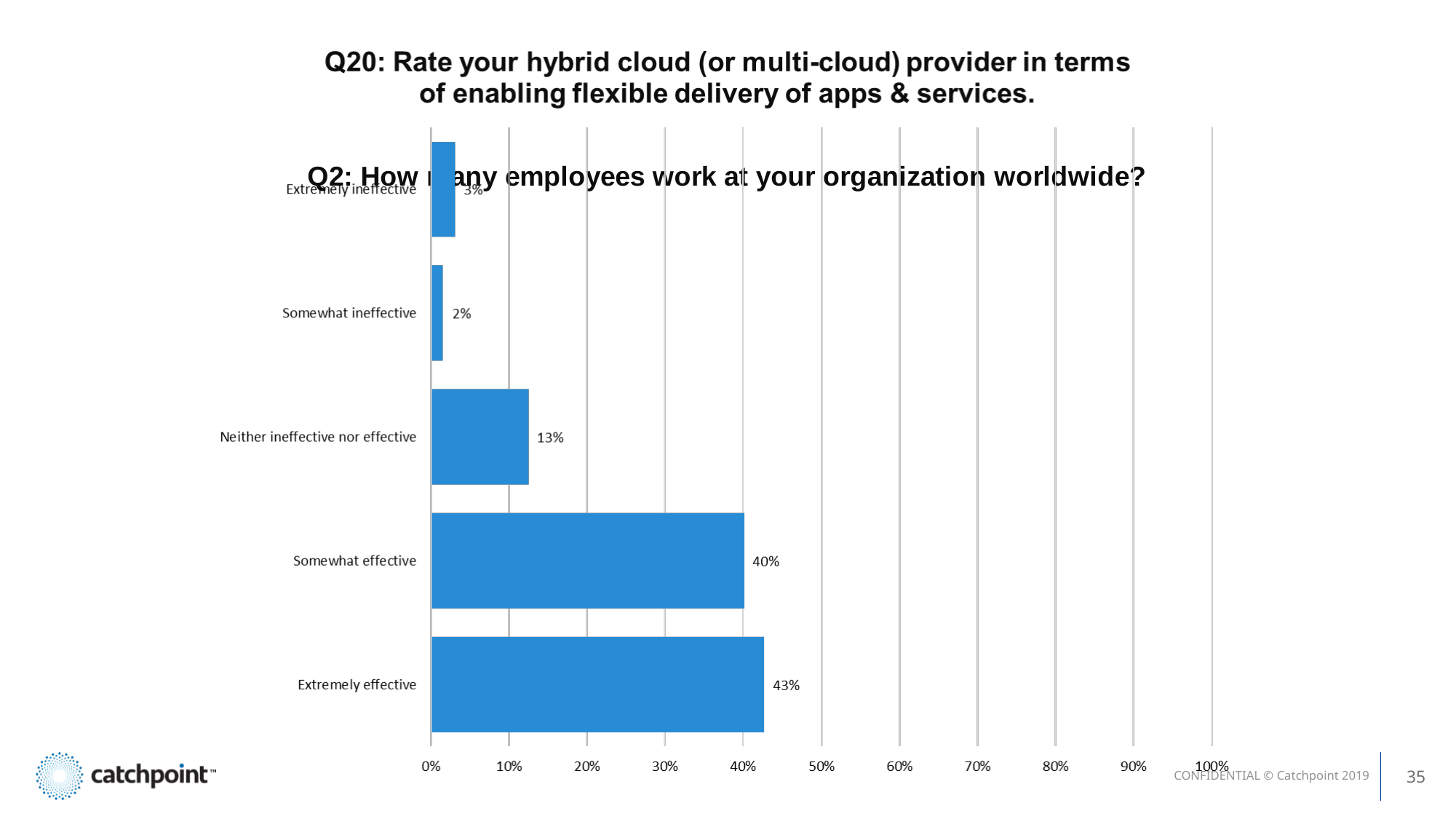
What is the difference between Somewhat effective and Neither ineffective nor effective? 27% Which category has the lowest value? Somewhat ineffective What is the value for Somewhat effective? 40% What is the difference between Extremely effective and Somewhat effective? 3% What is the value for Somewhat ineffective? 2% What is the value for Neither ineffective nor effective? 13% Which category has the highest value? Extremely effective What kind of chart is shown on the slide? Bar chart Which is larger, Neither ineffective nor effective or Somewhat ineffective? Neither ineffective nor effective How many categories are shown in the chart? 5 Is the value for Extremely effective greater or less than 40%? greater What is the value for Extremely effective? 43%